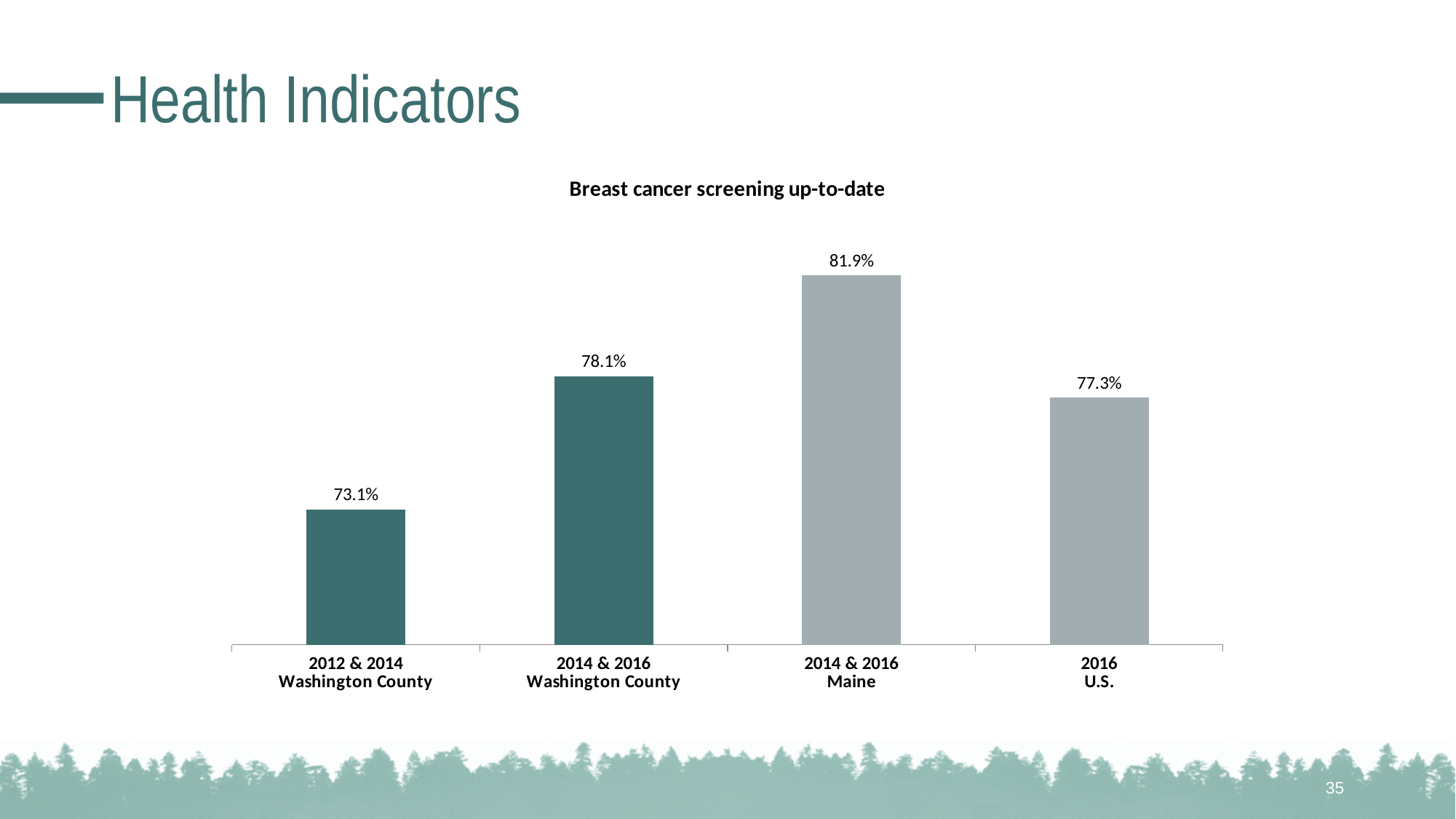
What is the value for 2014 & 2016 Washington County? 78.1% Which category has the highest value? 2014 & 2016 Maine What kind of chart is this? Bar chart What is the value for 2014 & 2016 Maine? 81.9% How many bars are shown in the chart? 4 Which is larger, the value for 2014 & 2016 Washington County or the value for 2016 U.S.? 2014 & 2016 Washington County Which category has the lowest value? 2012 & 2014 Washington County What is the title of the chart? Breast cancer screening up-to-date What is the difference between the 2014 & 2016 Maine value and the 2016 U.S. value? 4.6% What is the difference between the 2014 & 2016 Washington County value and the 2012 & 2014 Washington County value? 5.0% What is the value for 2012 & 2014 Washington County? 73.1% What is the value for 2016 U.S.? 77.3%